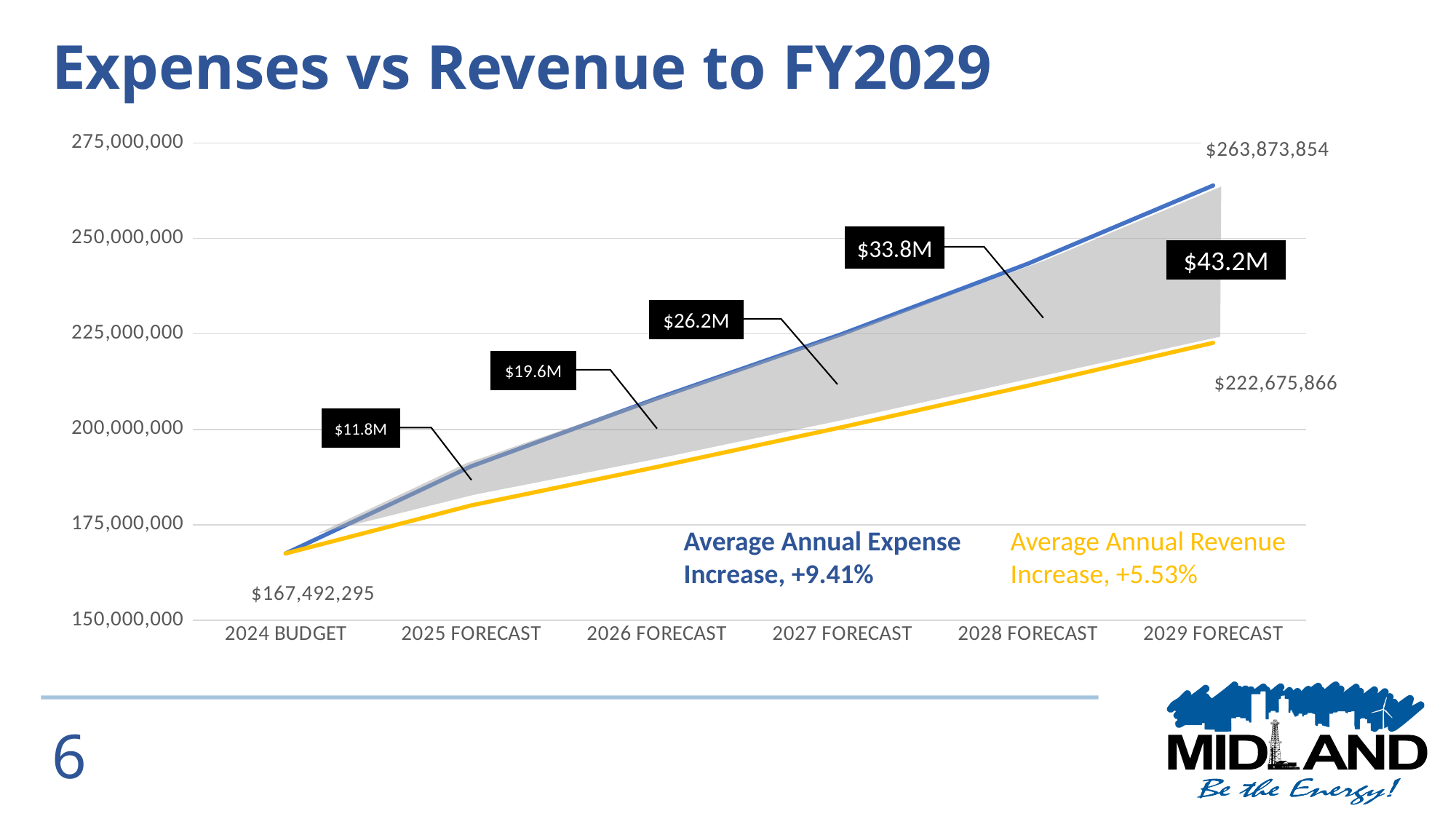
What is the value labelled at the 2024 BUDGET starting point? $167,492,295 Is the revenue value for the 2029 FORECAST greater or less than 225,000,000? less Do the expense and revenue lines rise or fall from 2024 BUDGET to 2029 FORECAST? rise What is the gap between expenses and revenue labelled for the 2025 FORECAST? $11.8M How many categories are shown on the x axis? 6 What is the expense value labelled for the 2029 FORECAST? $263,873,854 What is the average annual expense increase stated on the slide? +9.41% What is the gap between expenses and revenue labelled for the 2028 FORECAST? $33.8M What kind of chart is shown on the slide? line chart What is the gap between expenses and revenue labelled for the 2029 FORECAST? $43.2M What is the revenue value labelled for the 2029 FORECAST? $222,675,866 What is the title of the chart? Expenses vs Revenue to FY2029